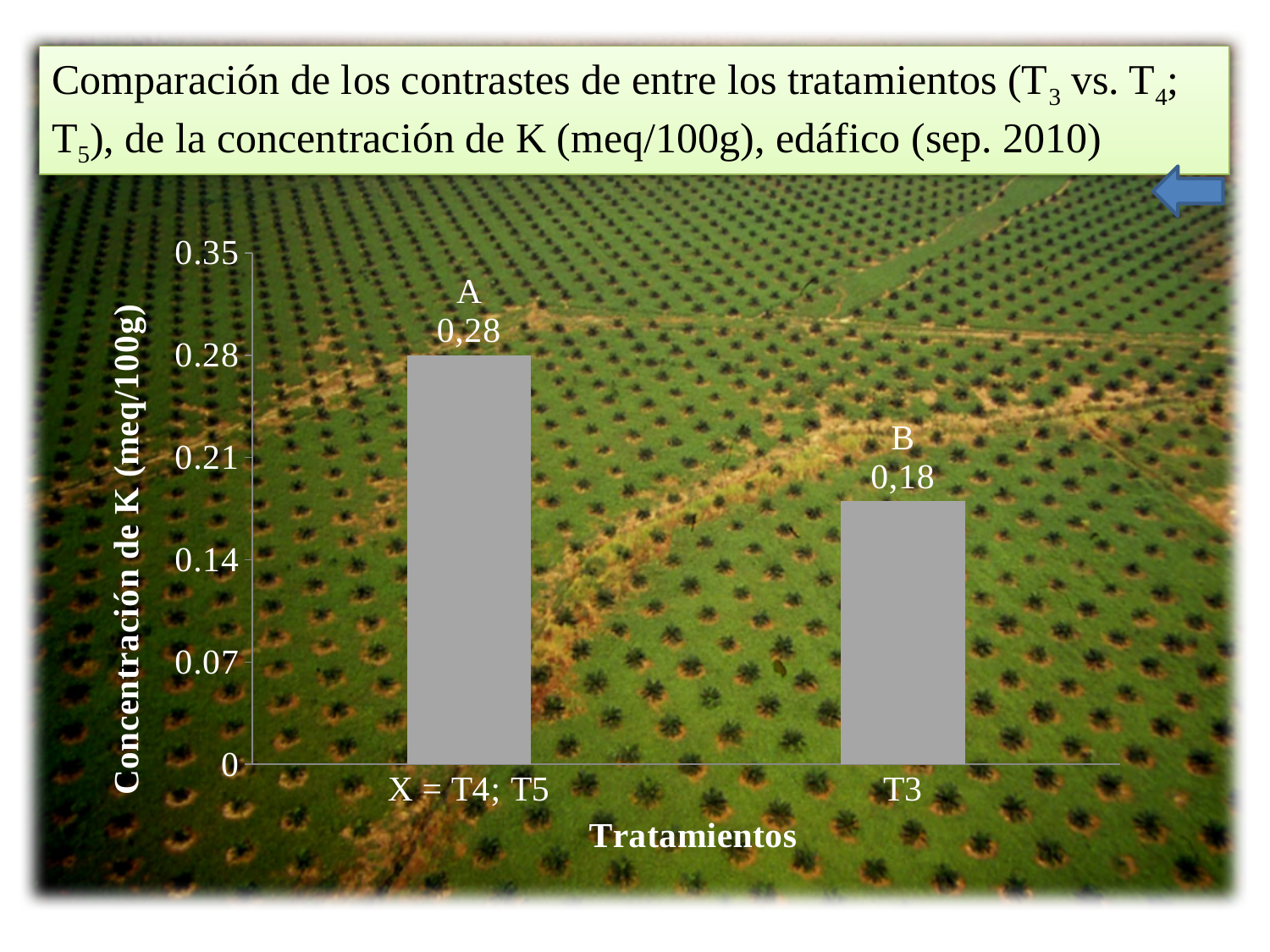
Is the value for T3 greater or less than 0.21? less What is the K concentration value for T3? 0,18 How many categories are shown on the x axis? 2 Which category has the lowest K concentration? T3 What is the difference between the K concentration for "X = T4; T5" and for T3? 0,10 Is the value for "X = T4; T5" greater or less than 0.21? greater What is the label of the y axis? Concentración de K (meq/100g) What is the K concentration value for the category "X = T4; T5"? 0,28 What kind of chart is shown on the slide? bar chart Which has a larger K concentration, "X = T4; T5" or T3? X = T4; T5 What letter is printed above the bar for T3? B Which category has the highest K concentration? X = T4; T5